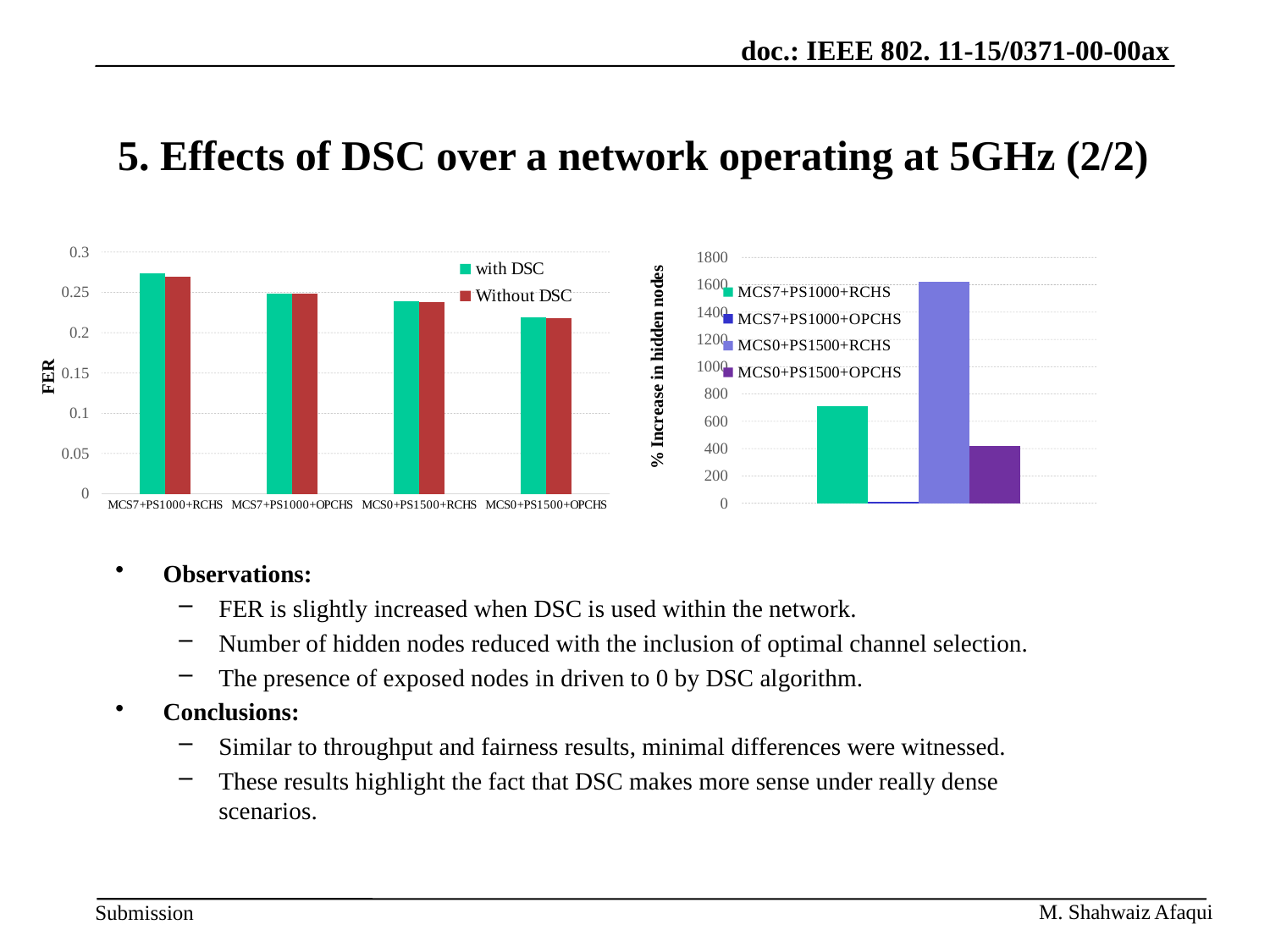
In the '% Increase in hidden nodes' chart on the right, is the value for MCS0+PS1500+RCHS greater or less than 1400? greater In the '% Increase in hidden nodes' chart on the right, which series has the lowest value? MCS7+PS1000+OPCHS What kind of chart is the FER chart on the left? bar chart In the '% Increase in hidden nodes' chart on the right, which is larger: the value for MCS7+PS1000+RCHS or the value for MCS0+PS1500+OPCHS? MCS7+PS1000+RCHS In the FER chart on the left, which category has the highest FER for the 'with DSC' series? MCS7+PS1000+RCHS In the FER chart on the left, do the 'with DSC' values rise or fall from left to right along the x axis? fall In the FER chart on the left, how many categories are shown on the x axis? 4 In the '% Increase in hidden nodes' chart on the right, which series has the highest value? MCS0+PS1500+RCHS In the FER chart on the left, is the 'Without DSC' value for MCS0+PS1500+OPCHS greater or less than 0.25? less In the FER chart on the left, is the 'with DSC' value for MCS7+PS1000+RCHS greater or less than 0.25? greater In the FER chart on the left, how many series does the legend list? 2 In the FER chart on the left, which category has the lowest FER for the 'Without DSC' series? MCS0+PS1500+OPCHS